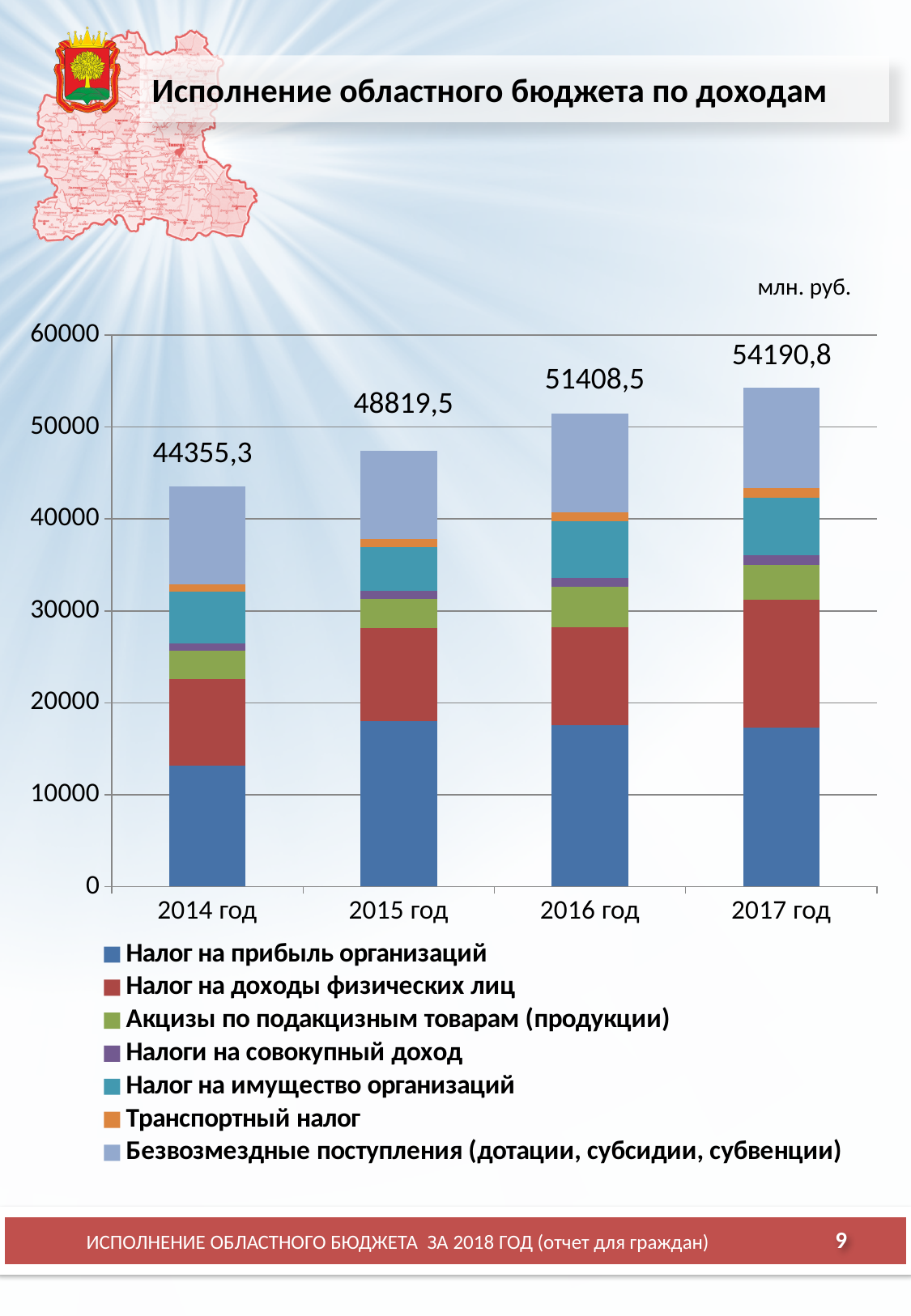
What is the difference between the total for 2016 год and the total for 2015 год? 2589,0 Which year has the lowest total revenue? 2014 год Do the total revenue values rise or fall from 2014 год to 2017 год? rise How many series does the legend list? 7 What is the total value labelled above the bar for 2016 год? 51408,5 Which year has the highest total revenue? 2017 год Is the value of Налог на прибыль организаций for 2014 год greater or less than 10000? greater Which is larger, the total for 2015 год or the total for 2016 год? 2016 год What is the difference between the total for 2017 год and the total for 2014 год? 9835,5 What is the total revenue value shown for 2014 год? 44355,3 What is the total revenue value shown for 2017 год? 54190,8 How many years are shown on the x axis? 4